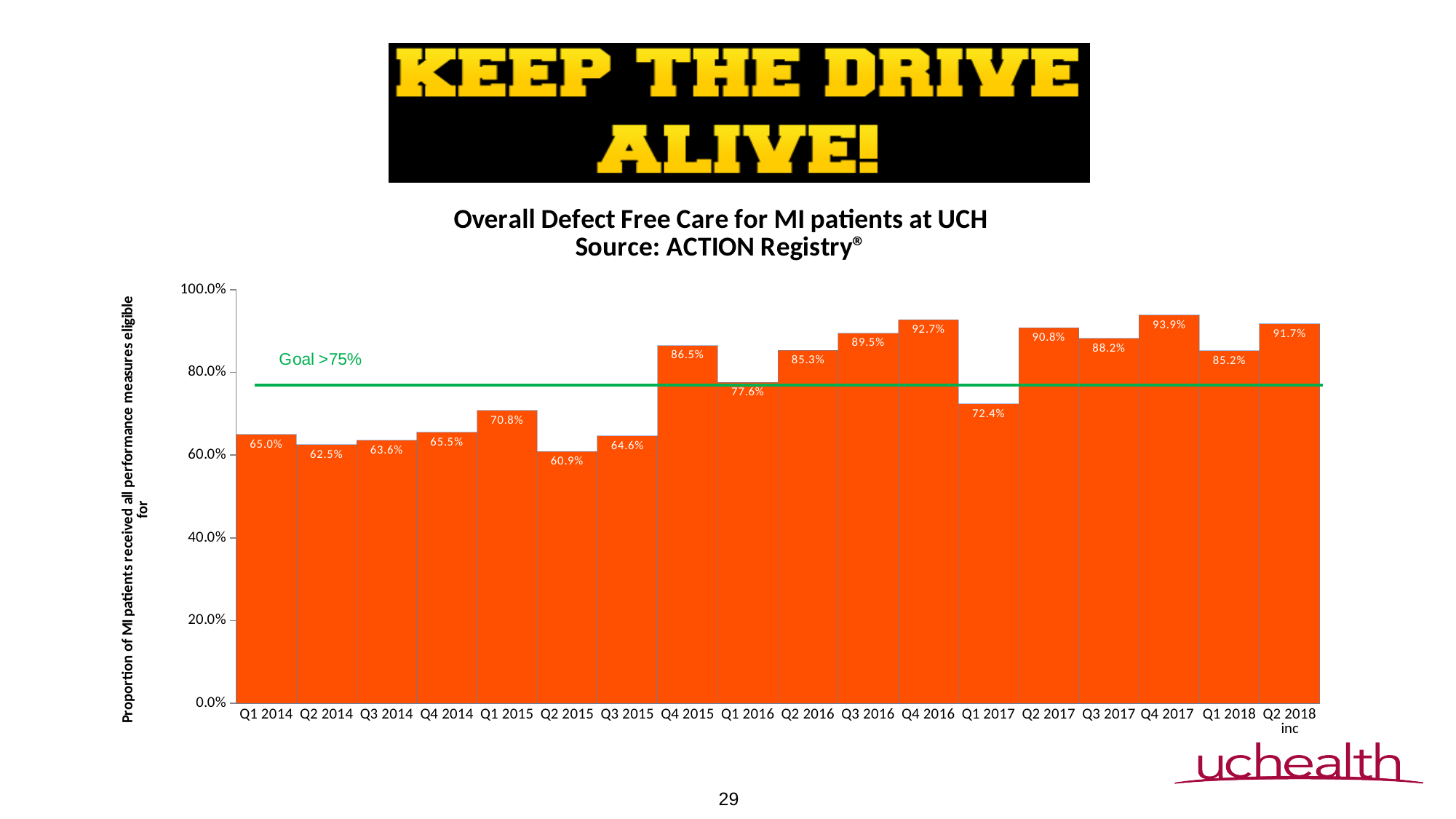
Which quarter has the highest value? Q4 2017 How many quarters are shown on the x axis? 18 What is the value for Q2 2015? 60.9% What kind of chart is this? bar chart What is the value for Q4 2016? 92.7% What goal is indicated by the green line on the chart? Goal >75% Is the value for Q1 2016 greater or less than 60.0%? greater Do the values generally rise or fall from Q1 2014 to Q2 2018? rise What is the difference between the values for Q4 2015 and Q3 2015? 21.9% Which is larger, the value for Q2 2017 or the value for Q3 2017? Q2 2017 Which quarter has the lowest value? Q2 2015 What is the value for Q1 2017? 72.4%